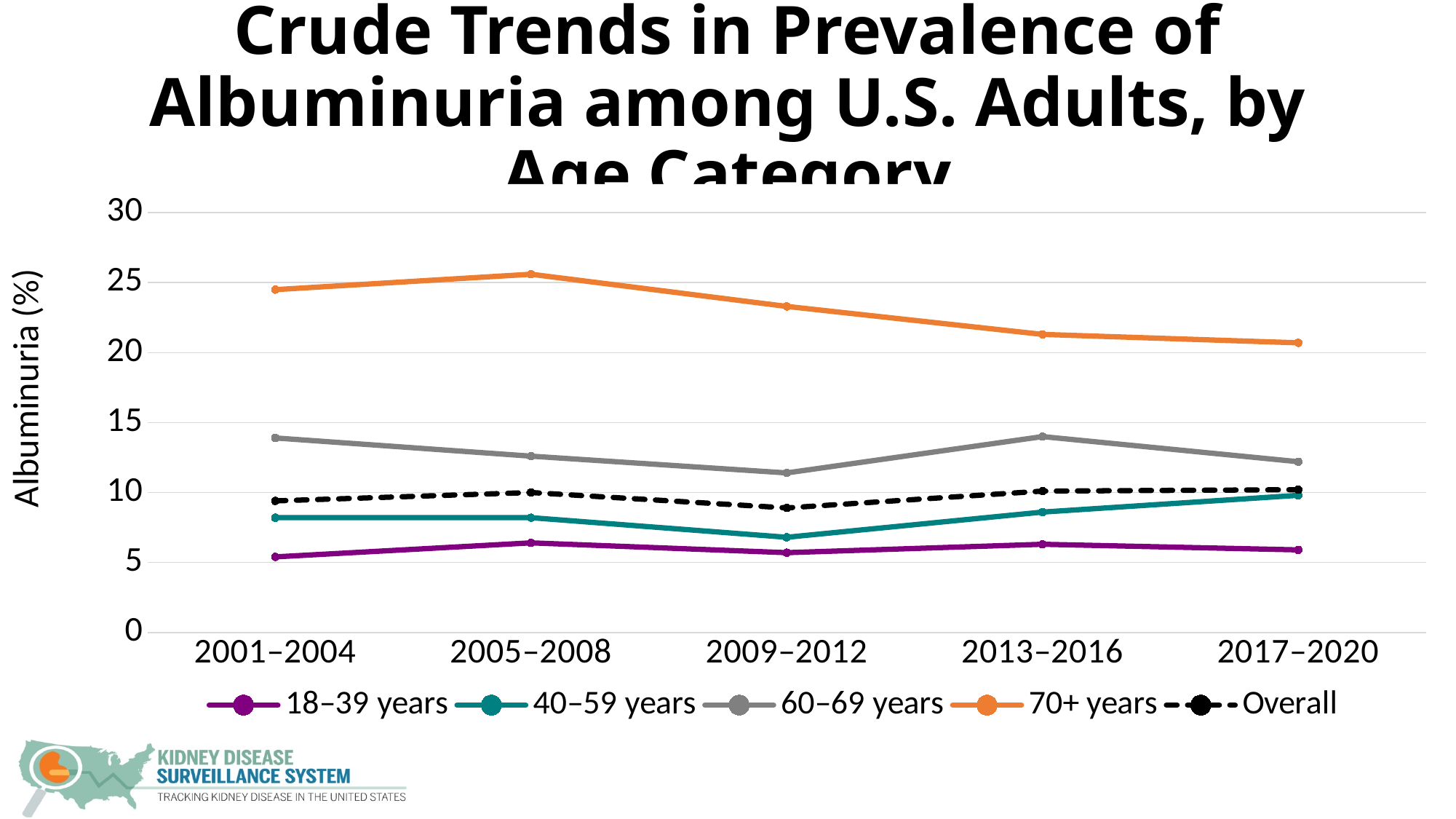
What is the label on the y axis? Albuminuria (%) Which age category has the lowest albuminuria prevalence across all periods? 18–39 years In 2013–2016, which is larger: the value for 60–69 years or the Overall value? 60–69 years What kind of chart is shown on the slide? line chart How many series does the legend list? 5 In which period does the 40–59 years line reach its lowest value? 2009–2012 Is the value for 60–69 years in 2001–2004 greater or less than 15? less Which age category has the highest albuminuria prevalence across all periods? 70+ years In which period does the 70+ years line reach its highest value? 2005–2008 How many time periods are shown on the x axis? 5 Does the 70+ years line rise or fall from 2005–2008 to 2017–2020? fall Is the value for 70+ years in 2017–2020 greater or less than 20? greater